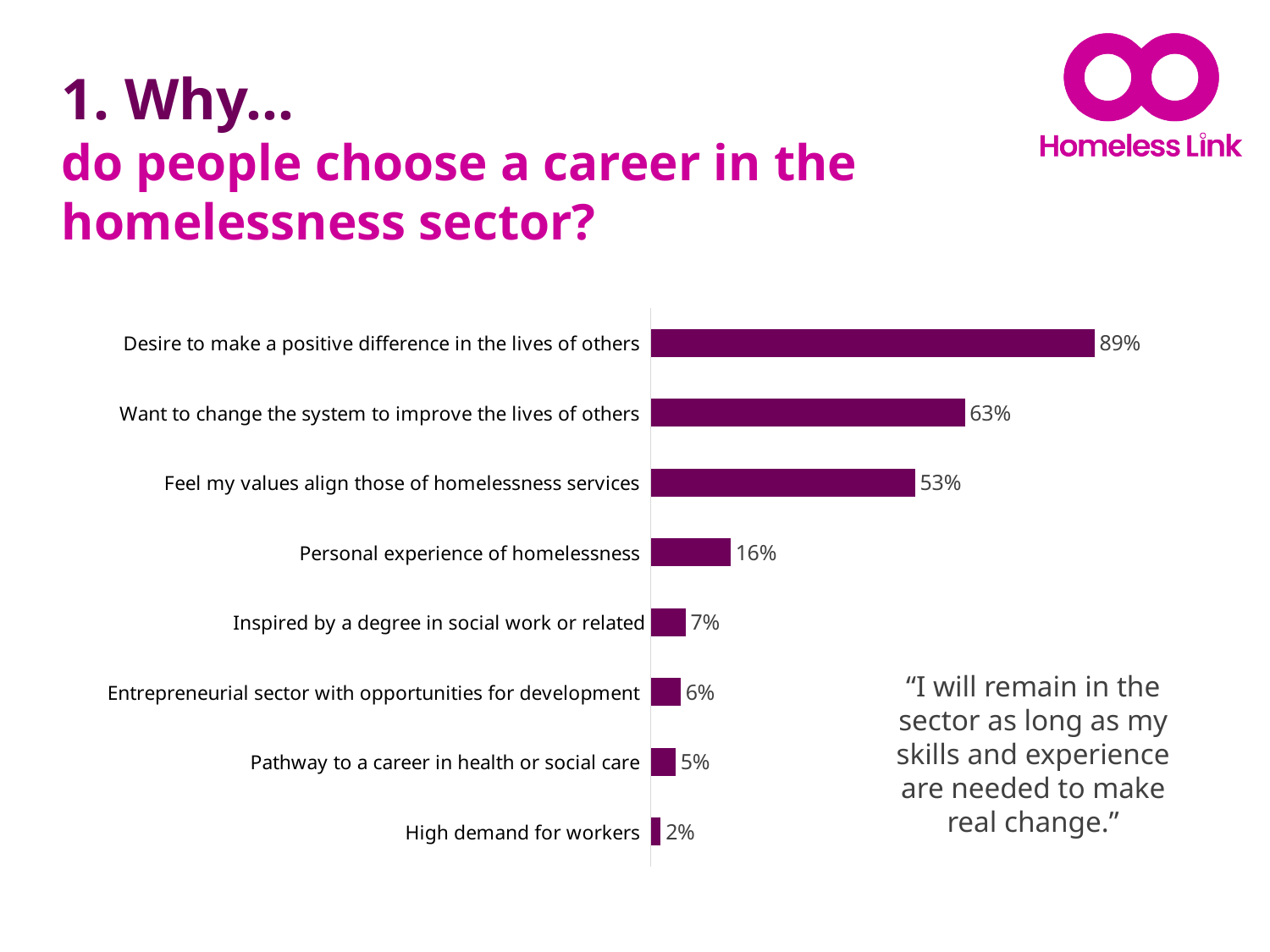
What type of chart is shown on the slide? Bar chart What percentage of respondents cited 'Desire to make a positive difference in the lives of others'? 89% Do the values increase or decrease from the top bar to the bottom bar? Decrease Which is larger: 'Inspired by a degree in social work or related' or 'Entrepreneurial sector with opportunities for development'? Inspired by a degree in social work or related What is the value for 'Personal experience of homelessness'? 16% How many reasons are listed on the chart? 8 What colour are the bars in the chart? Purple What percentage is shown for 'Pathway to a career in health or social care'? 5% Which reason has the lowest percentage? High demand for workers What is the difference between the highest and lowest values on the chart? 87% What is the difference between 'Want to change the system to improve the lives of others' and 'Feel my values align those of homelessness services'? 10% Which reason has the highest percentage? Desire to make a positive difference in the lives of others